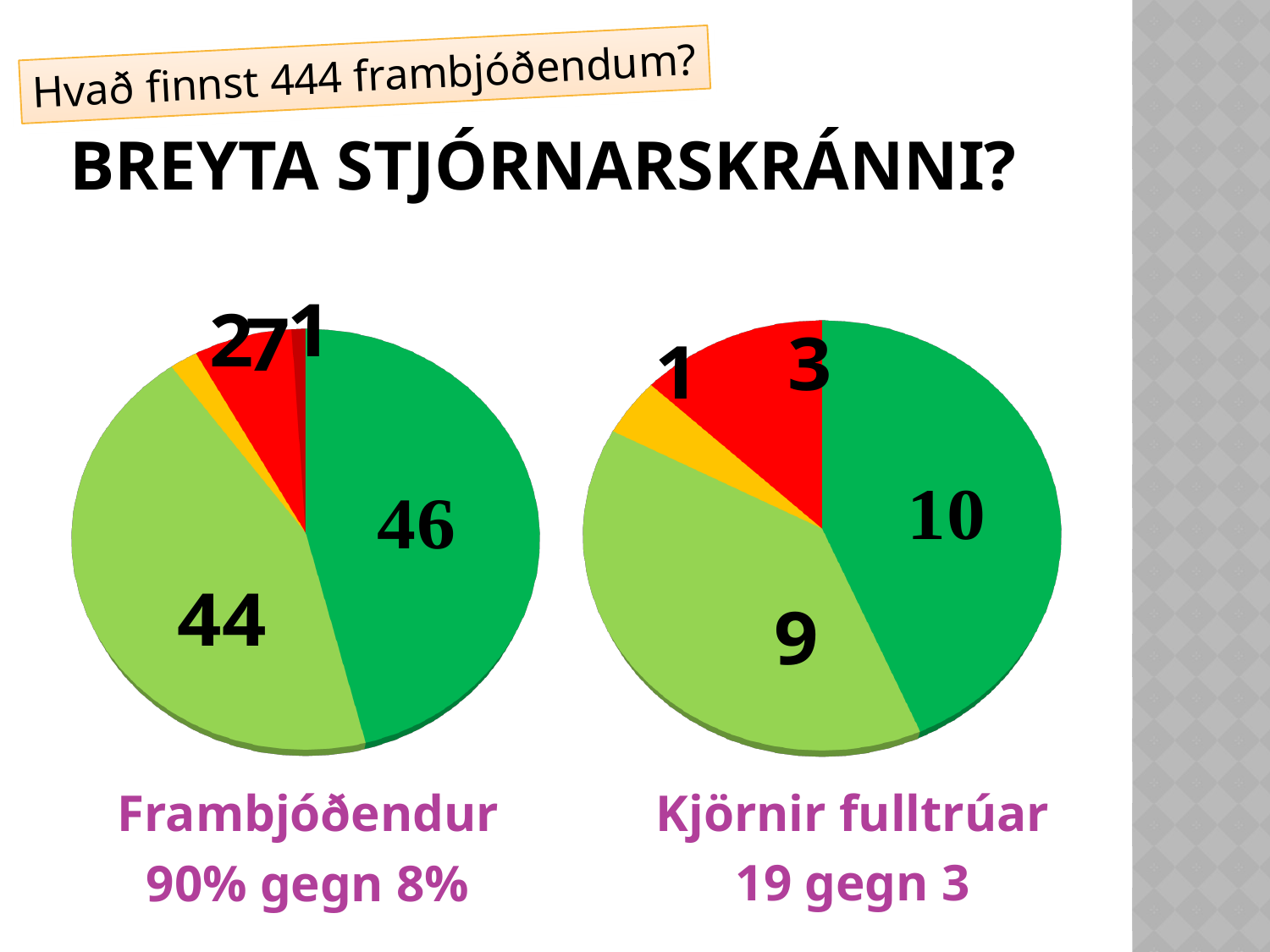
In the right pie chart (Kjörnir fulltrúar), what is the difference between the dark green slice and the light green slice? 1 In the right pie chart (Kjörnir fulltrúar), what value is shown on the dark green slice? 10 In the left pie chart (Frambjóðendur), what value is shown on the dark green slice? 46 In the right pie chart (Kjörnir fulltrúar), what value is shown on the red slice? 3 In the left pie chart (Frambjóðendur), what value is shown on the light green slice? 44 What kind of charts are shown on the slide? Pie charts In the left pie chart (Frambjóðendur), which slice is the largest? The dark green slice (46) In the right pie chart (Kjörnir fulltrúar), which slice is the smallest? The yellow slice (1) In the right pie chart (Kjörnir fulltrúar), what value is shown on the light green slice? 9 How many slices does the right pie chart (Kjörnir fulltrúar) have? 4 In the right pie chart (Kjörnir fulltrúar), what value is shown on the yellow slice? 1 In the left pie chart (Frambjóðendur), which is larger, the dark green slice or the light green slice? The dark green slice